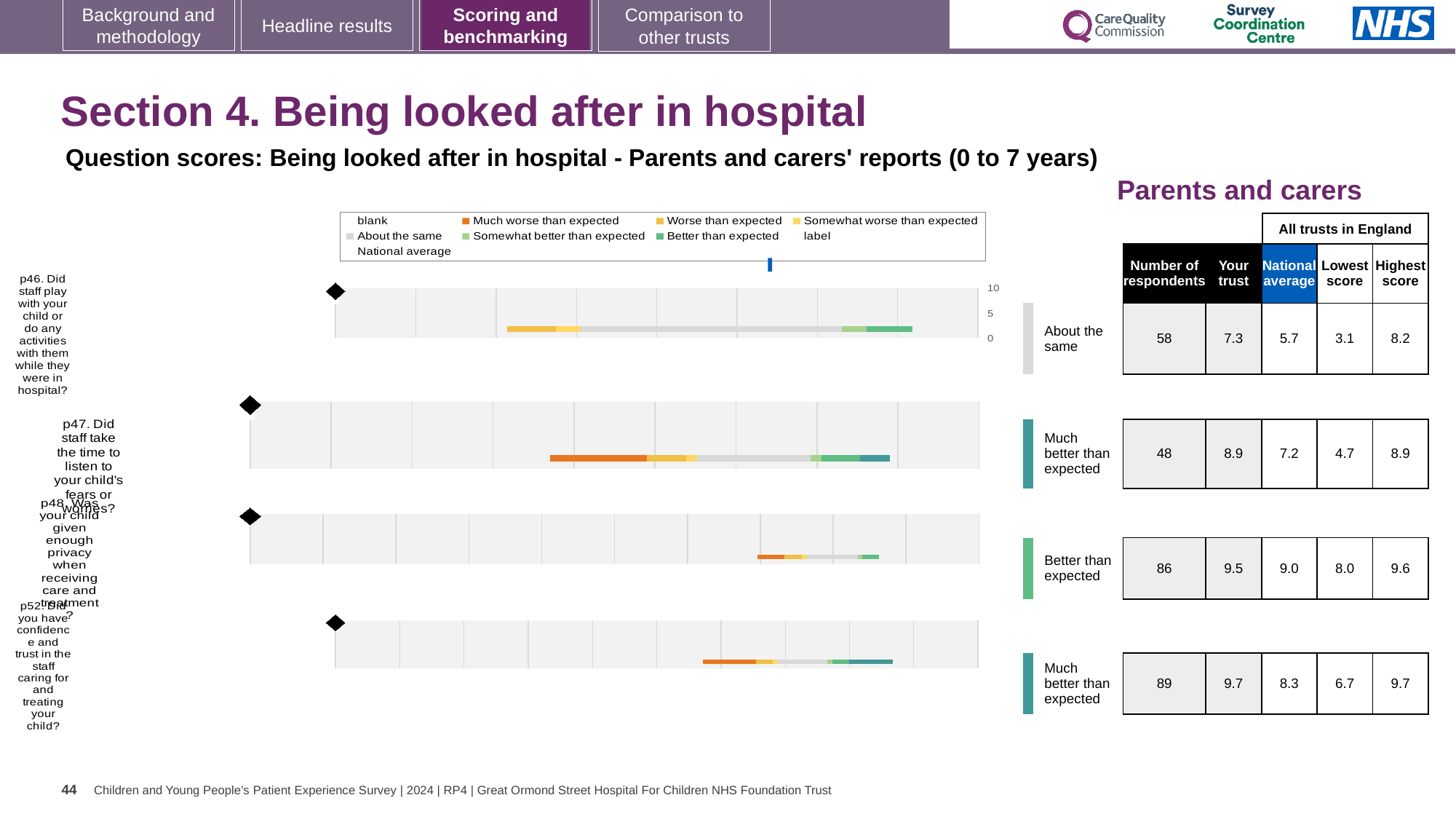
For p48, how much higher is the 'Your trust' score than the national average? 0.5 What is the lowest score among all trusts in England for p52? 6.7 What is the 'Your trust' score for p46 (Did staff play with your child or do any activities with them while they were in hospital?)? 7.3 What kind of chart is used to show the question scores for p46 to p52 on this slide? bar chart Which question has the highest 'Your trust' score? p52 For p47, which is larger: the 'Your trust' score or the national average? Your trust How many survey questions (chart rows) are shown on the slide? 4 What is the highest score among all trusts in England for p48? 9.6 What is the national average score for p47 (Did staff take the time to listen to your child's fears or worries?)? 7.2 What benchmark category is shown for p46? About the same Which question has the lowest 'Your trust' score? p46 How many respondents answered p52 (Did you have confidence and trust in the staff caring for and treating your child?)? 89